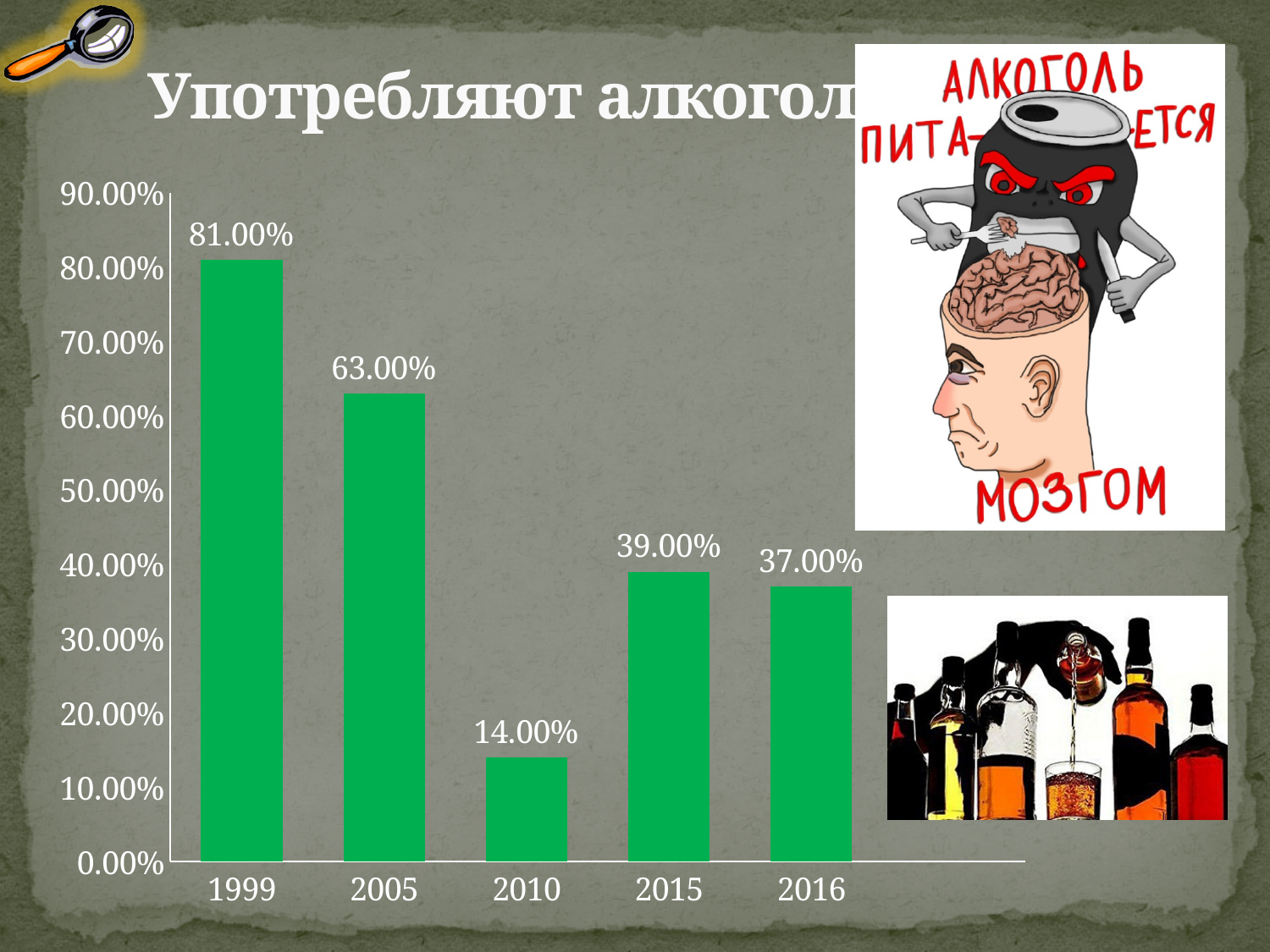
Which year has the highest value? 1999 What is the difference between the values for 2015 and 2016? 2.00% Which year has the lowest value? 2010 What is the difference between the values for 1999 and 2005? 18.00% Is the value for 2015 greater or less than 30.00%? greater What colour are the bars in the chart? green What kind of chart is shown on the slide? bar chart What is the value for 2010? 14.00% Which is larger, the value for 2005 or the value for 2015? 2005 How many years are shown on the x axis? 5 What is the value for 1999? 81.00% What is the value for 2016? 37.00%